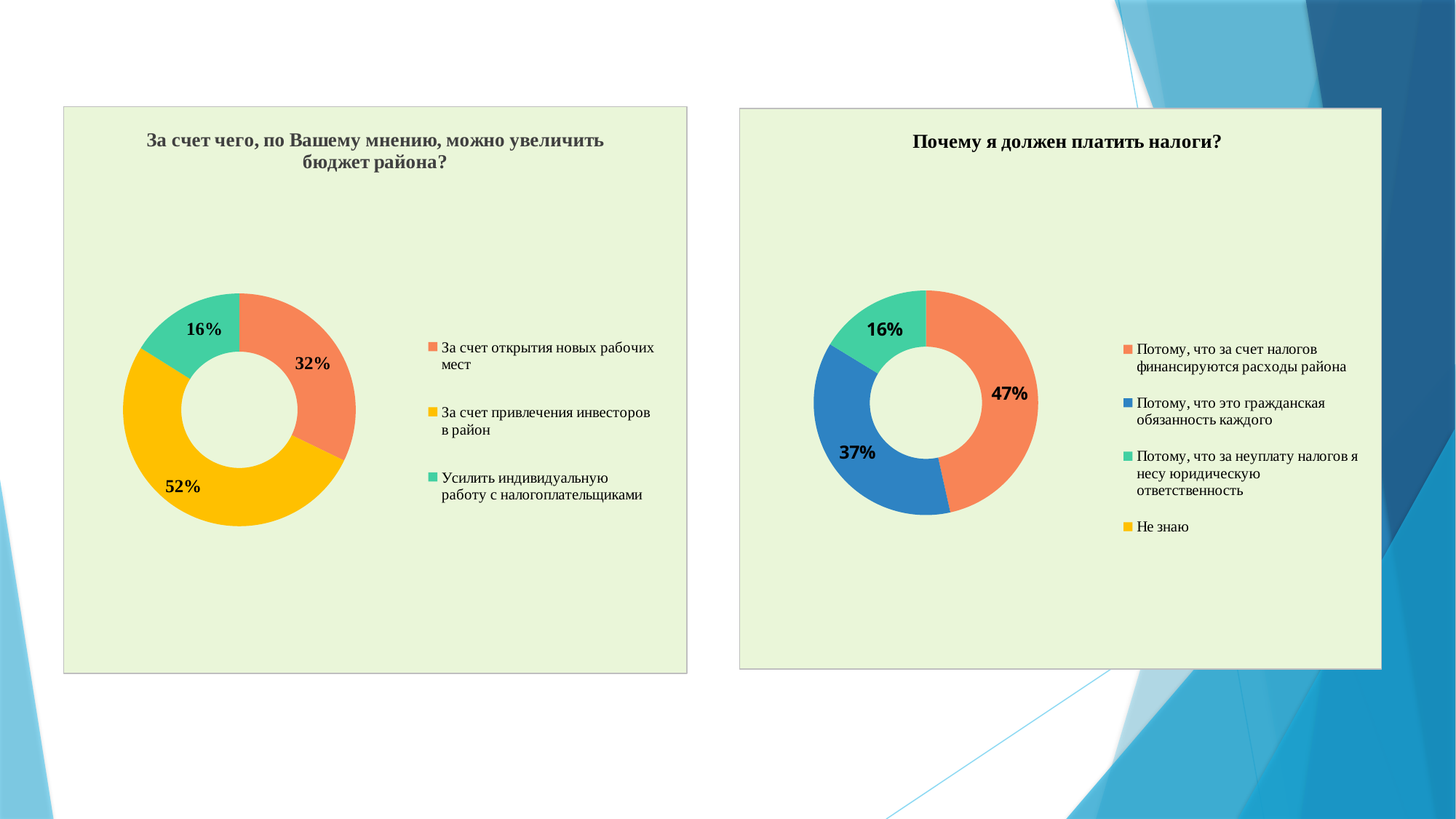
In the right chart 'Почему я должен платить налоги?', what share is shown for 'Потому, что это гражданская обязанность каждого'? 37% In the left chart 'За счет чего, по Вашему мнению, можно увеличить бюджет района?', what is the difference in percentage points between 'За счет привлечения инвесторов в район' and 'За счет открытия новых рабочих мест'? 20 percentage points In the left chart 'За счет чего, по Вашему мнению, можно увеличить бюджет района?', what share is shown for 'За счет открытия новых рабочих мест'? 32% In the right chart 'Почему я должен платить налоги?', what share is shown for 'Потому, что за счет налогов финансируются расходы района'? 47% In the left chart 'За счет чего, по Вашему мнению, можно увеличить бюджет района?', what share is shown for 'За счет привлечения инвесторов в район'? 52% In the right chart 'Почему я должен платить налоги?', which is larger: the share for 'Потому, что это гражданская обязанность каждого' or for 'Потому, что за неуплату налогов я несу юридическую ответственность'? Потому, что это гражданская обязанность каждого In the right chart 'Почему я должен платить налоги?', which answer has the largest share? Потому, что за счет налогов финансируются расходы района In the left chart 'За счет чего, по Вашему мнению, можно увеличить бюджет района?', which option has the largest share? За счет привлечения инвесторов в район What type of chart is the left chart 'За счет чего, по Вашему мнению, можно увеличить бюджет района?'? Doughnut (pie) chart In the right chart 'Почему я должен платить налоги?', what is the difference in percentage points between the 47% and 37% slices? 10 percentage points In the left chart 'За счет чего, по Вашему мнению, можно увеличить бюджет района?', which option has the smallest share? Усилить индивидуальную работу с налогоплательщиками In the right chart 'Почему я должен платить налоги?', how many entries does the legend list? 4